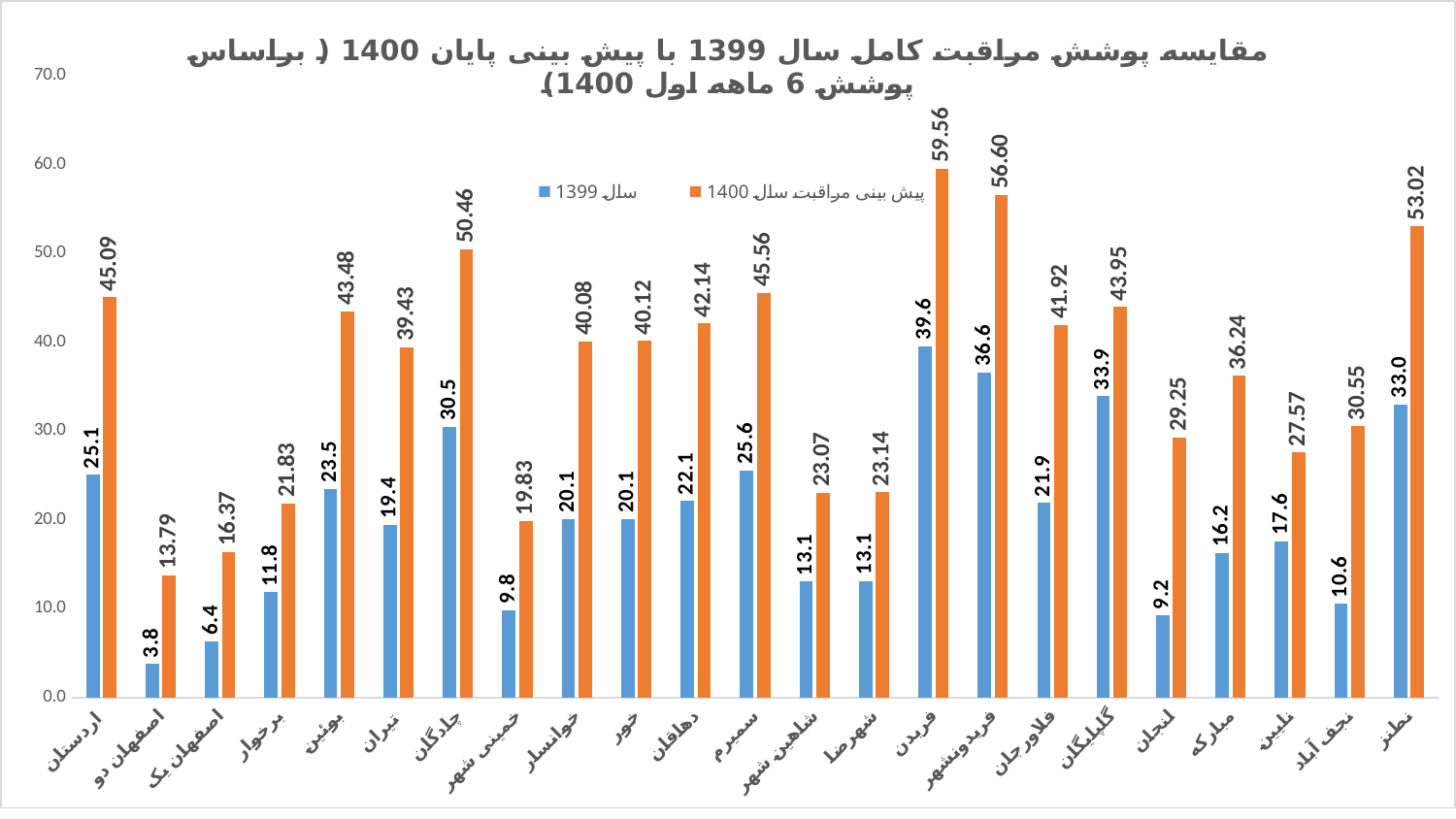
How many categories are shown on the x axis? 23 Which category has the lowest value in the سال 1399 series? اصفهان دو Which category has the highest value in the پیش بینی مراقبت سال 1400 series? فریدن What type of chart is shown on the slide? bar chart Is the پیش بینی مراقبت سال 1400 value for لنجان greater or less than 30.0? less What is the value for چادگان in the سال 1399 series? 30.5 What is the value for خمینی شهر in the سال 1399 series? 9.8 What is the value for نطنز in the پیش بینی مراقبت سال 1400 series? 53.02 Which colour represents the سال 1399 series? blue How many series does the legend list? 2 What is the difference between the پیش بینی مراقبت سال 1400 value and the سال 1399 value for فریدونشهر? 20.00 Which is larger: the سال 1399 value for گلپایگان or the سال 1399 value for نطنز? گلپایگان